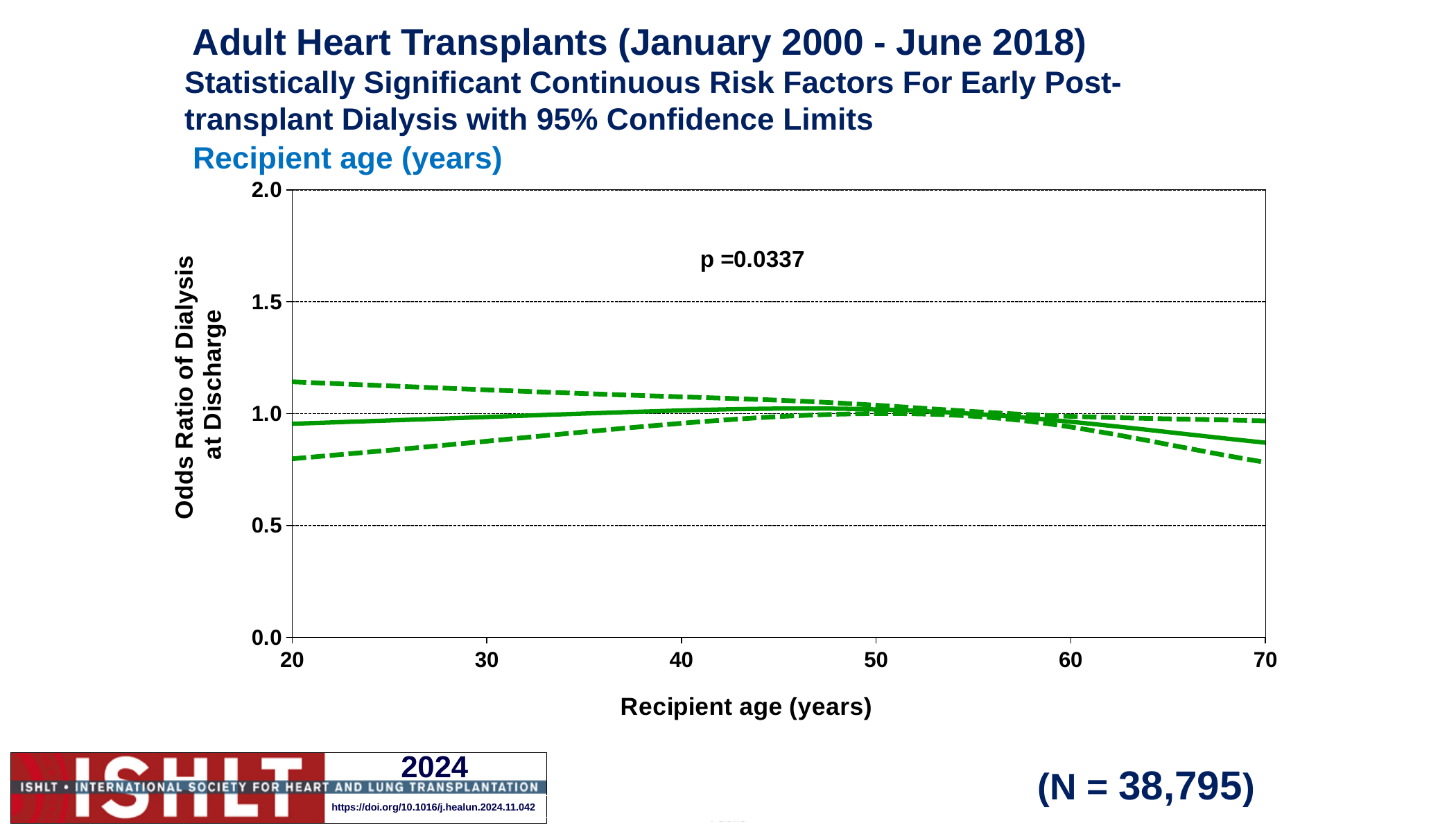
Is the odds ratio (solid line) at recipient age 20 larger or smaller than at recipient age 50? smaller What is the sample size (N) shown on the slide? 38,795 Does the odds ratio (solid line) rise or fall as recipient age increases from 50 to 70 years? fall Is the lower 95% confidence limit (lower dashed line) at recipient age 20 greater or less than 1.0? less Is the upper 95% confidence limit (upper dashed line) at recipient age 20 greater or less than 1.0? greater Is the lower 95% confidence limit (lower dashed line) at recipient age 70 greater or less than 0.5? greater Does the lower 95% confidence limit (lower dashed line) rise or fall as recipient age increases from 20 to 50 years? rise How many lines are plotted on the chart? 3 What p-value is printed on the chart? p =0.0337 What kind of chart is shown on the slide? line chart